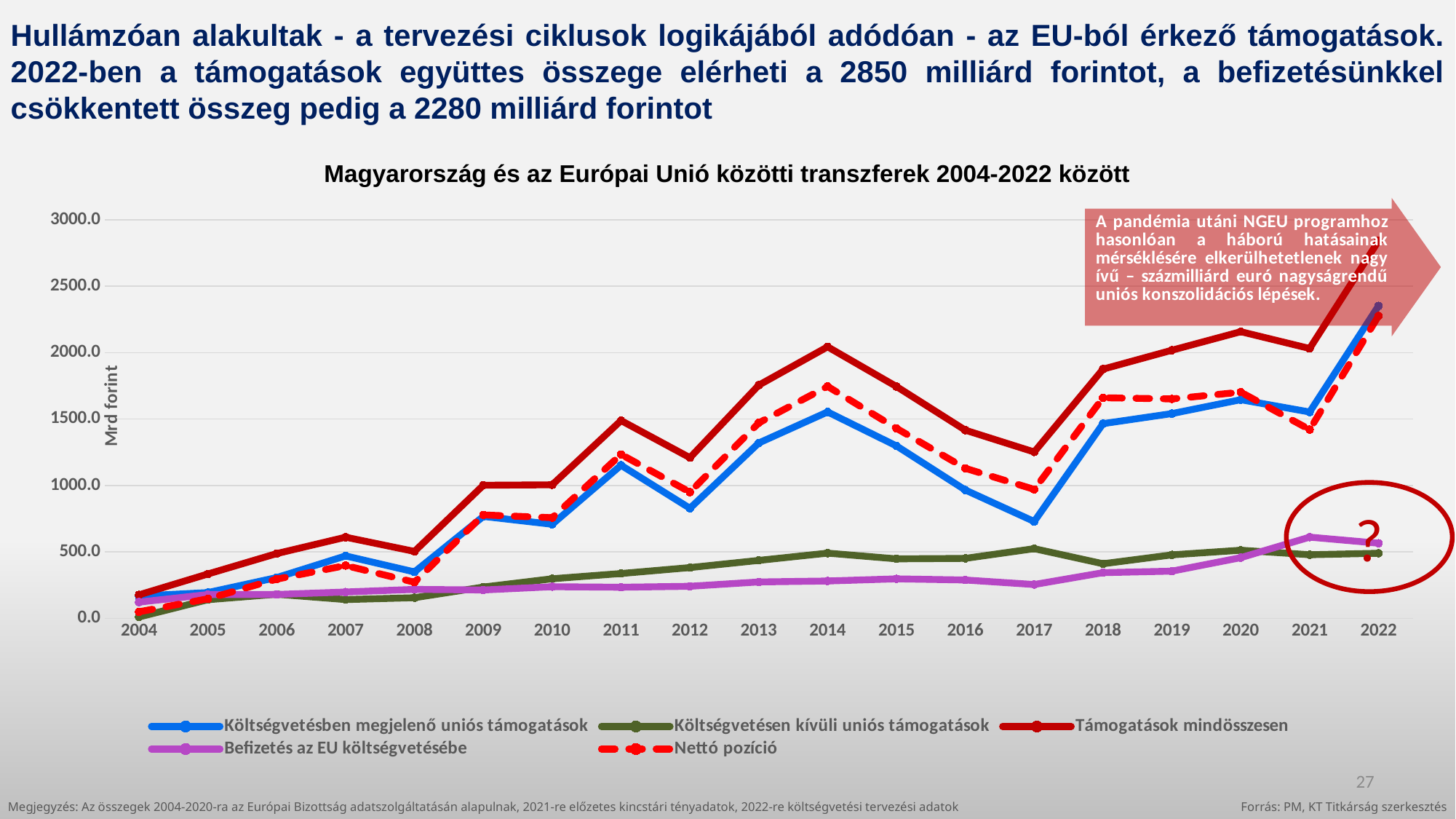
Is the value of Nettó pozíció in 2021 greater or less than 1000? greater How many series does the legend list? 5 What is the label on the y axis of the chart? Mrd forint Does the Támogatások mindösszesen series rise or fall between 2014 and 2017? fall In which year is the Költségvetésen kívüli uniós támogatások series at its lowest? 2004 Is the value of Támogatások mindösszesen in 2014 greater or less than 1500? greater What kind of chart is shown on the slide? line chart Is the value of Költségvetésben megjelenő uniós támogatások in 2017 greater or less than 1000? less How many years are plotted along the x axis? 19 In which year does the Támogatások mindösszesen series reach its highest value? 2022 In 2014, which is larger: Támogatások mindösszesen or Költségvetésen kívüli uniós támogatások? Támogatások mindösszesen